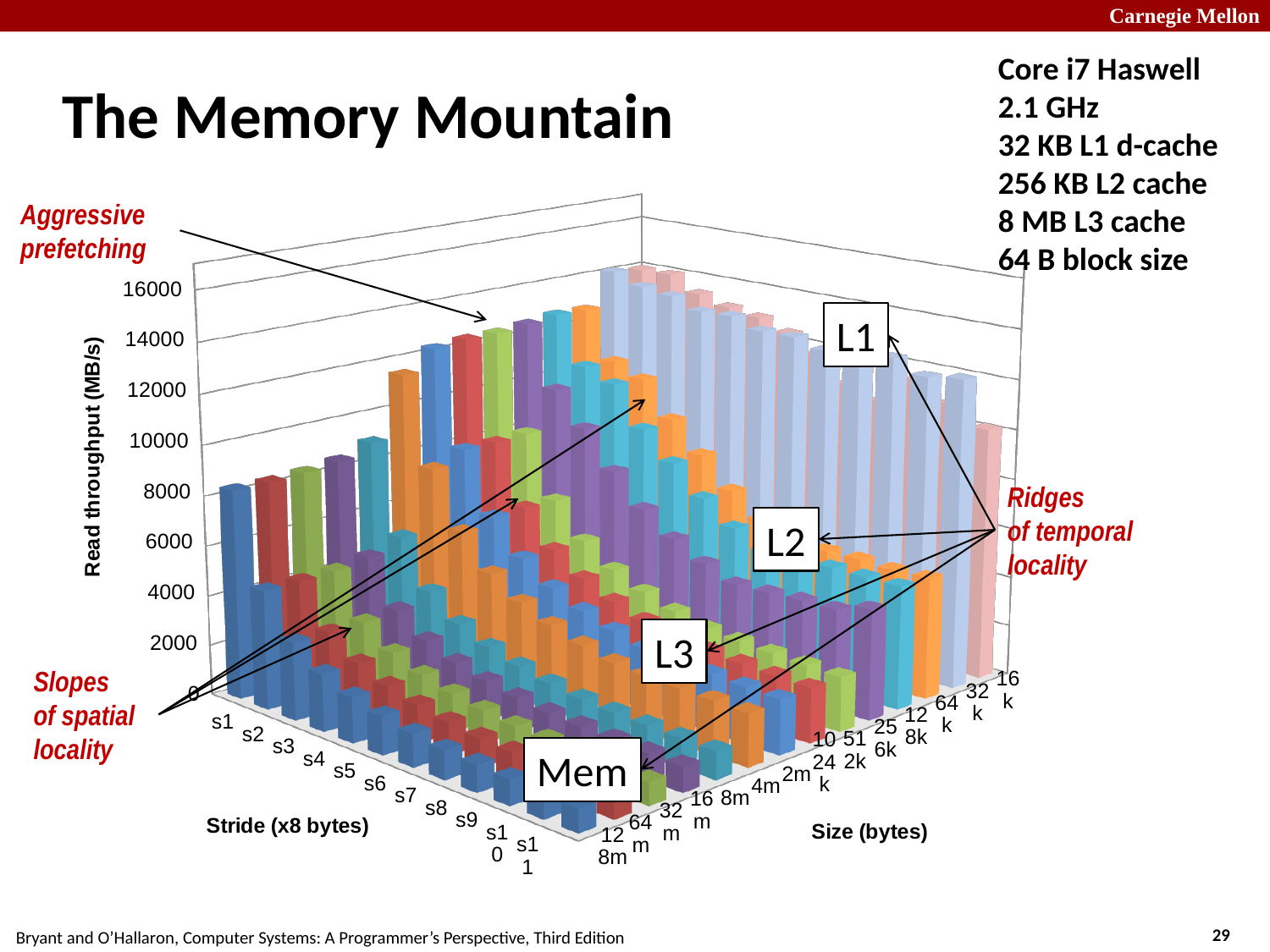
At stride s1, which size has the larger read throughput, 16k or 8m? 16k What kind of chart is shown on the slide? bar chart Is the read throughput for stride s11 at size 8m greater or less than 2000? less Is the read throughput for stride s1 at size 16k greater or less than 12000? greater Is the read throughput for stride s1 at size 8m greater or less than 4000? greater What is the highest tick value shown on the vertical axis? 16000 How many stride categories are plotted along the stride axis? 11 At size 16k, which stride has the larger read throughput, s1 or s11? s1 Which stride has the lowest read throughput? s11 Which stride has the highest read throughput? s1 What is the label of the vertical axis? Read throughput (MB/s) For a given size, does read throughput rise or fall as the stride increases from s1 to s11? fall